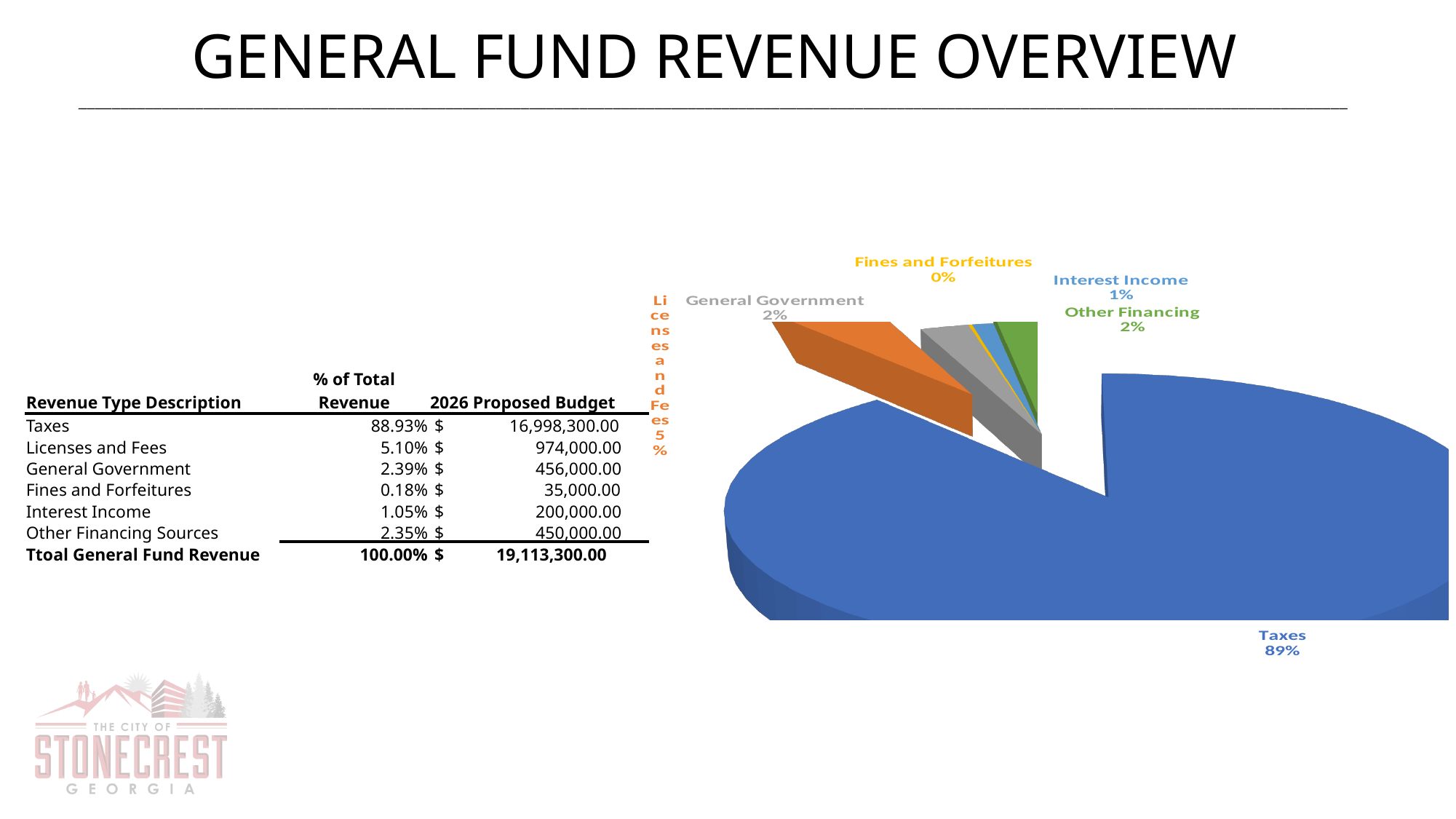
What percentage is shown for Interest Income in the pie chart? 1% What percentage is shown for General Government in the pie chart? 2% What kind of chart is shown on the slide? pie chart What percentage is shown for Licenses and Fees in the pie chart? 5% What percentage is shown for Fines and Forfeitures in the pie chart? 0% Which category has the largest slice in the pie chart? Taxes What colour is the Taxes slice in the pie chart? blue Which category has the smallest slice in the pie chart? Fines and Forfeitures What share of the pie chart does Taxes represent? 89% How many slices does the pie chart have? 6 In the pie chart, which is larger: Licenses and Fees or General Government? Licenses and Fees What is the difference in percentage points between the Taxes slice and the Licenses and Fees slice in the pie chart? 84%